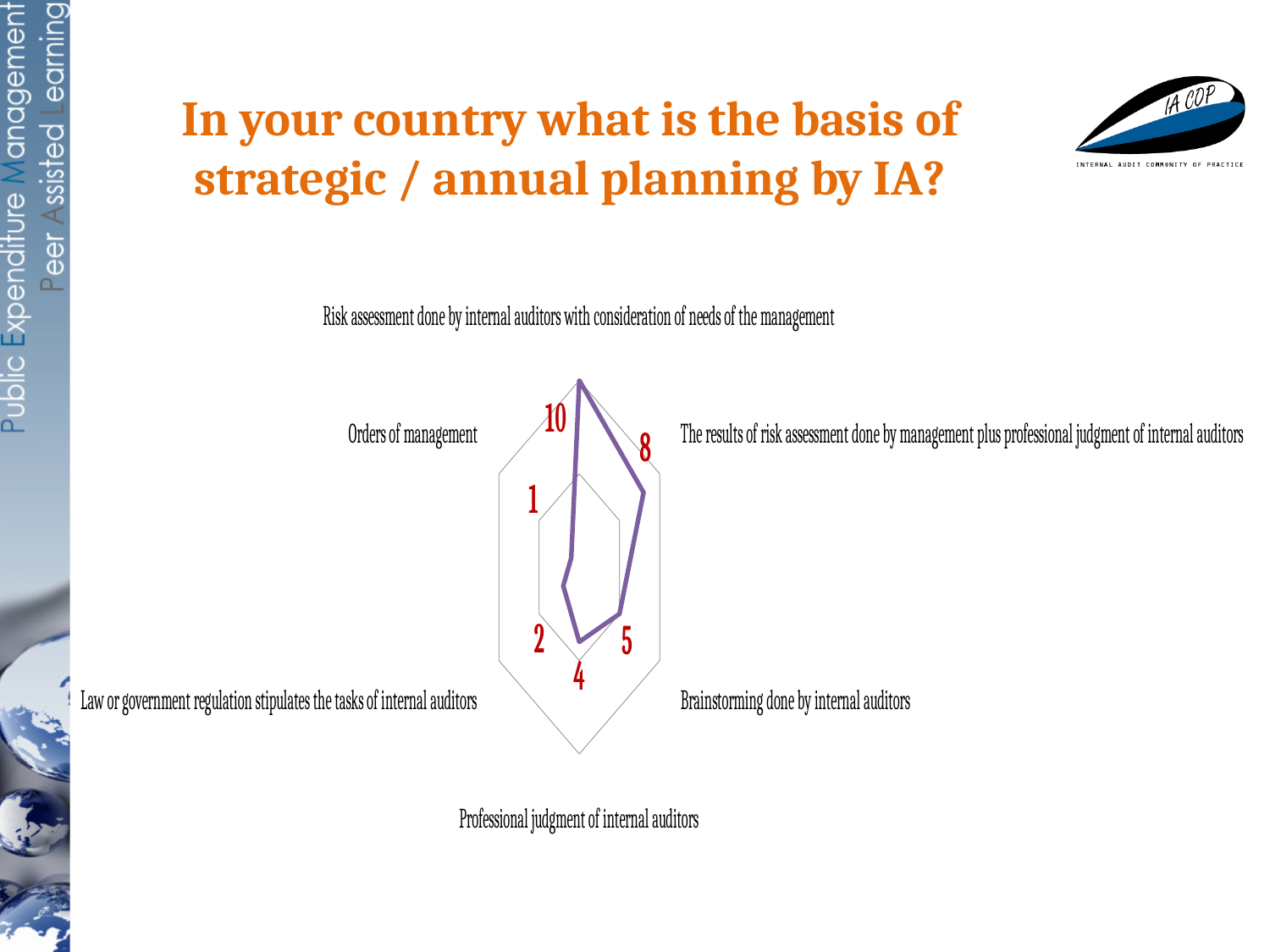
What is the value for "Professional judgment of internal auditors"? 4 Which category has the highest value? Risk assessment done by internal auditors with consideration of needs of the management What is the value for "Brainstorming done by internal auditors"? 5 What is the value for "Law or government regulation stipulates the tasks of internal auditors"? 2 What is the value for "The results of risk assessment done by management plus professional judgment of internal auditors"? 8 What is the difference between the values for "Risk assessment done by internal auditors with consideration of needs of the management" and "Brainstorming done by internal auditors"? 5 What kind of chart is shown on the slide? Radar chart Which is larger, the value for "Professional judgment of internal auditors" or the value for "Law or government regulation stipulates the tasks of internal auditors"? Professional judgment of internal auditors What is the value for "Orders of management"? 1 Which category has the lowest value? Orders of management What is the value for "Risk assessment done by internal auditors with consideration of needs of the management"? 10 How many categories does the chart have? 6